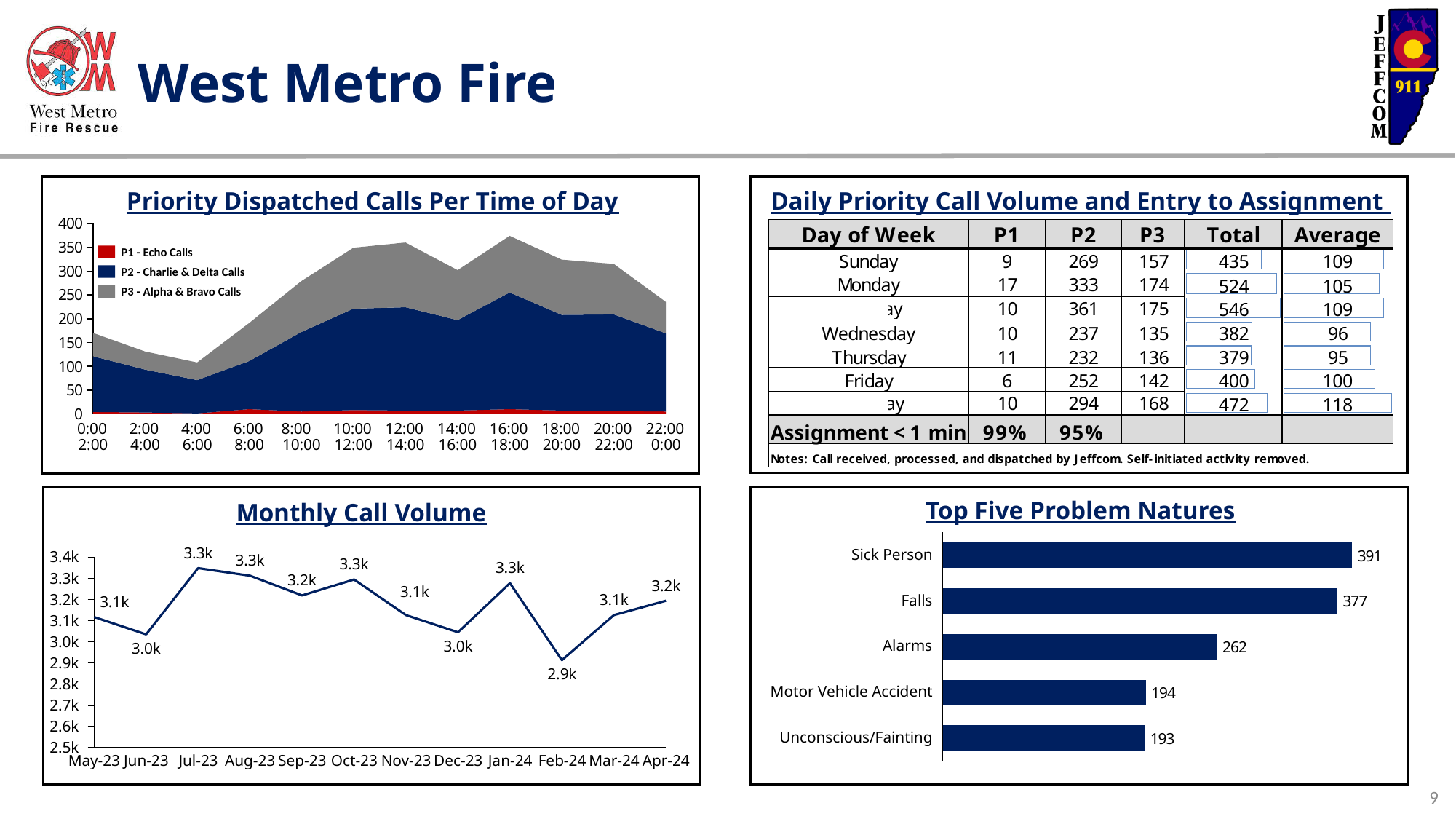
In the Monthly Call Volume chart, which month has the lowest call volume? Feb-24 In the Top Five Problem Natures chart, what is the difference between Sick Person and Falls? 14 In the Top Five Problem Natures chart, which is larger: Alarms or Motor Vehicle Accident? Alarms In the Top Five Problem Natures chart, which problem nature has the highest value? Sick Person In the Monthly Call Volume chart, what is the value for Feb-24? 2.9k In the Top Five Problem Natures chart, how many problem natures are shown? 5 In the Monthly Call Volume chart, how many months are plotted? 12 In the Monthly Call Volume chart, does the value rise or fall from Dec-23 to Jan-24? Rise In the Top Five Problem Natures chart, what is the value for Falls? 377 In the Priority Dispatched Calls Per Time of Day chart, how many series does the legend list? 3 In the Priority Dispatched Calls Per Time of Day chart, is the total for the 16:00-18:00 period greater or less than 350? greater What kind of chart is the Top Five Problem Natures chart? Bar chart